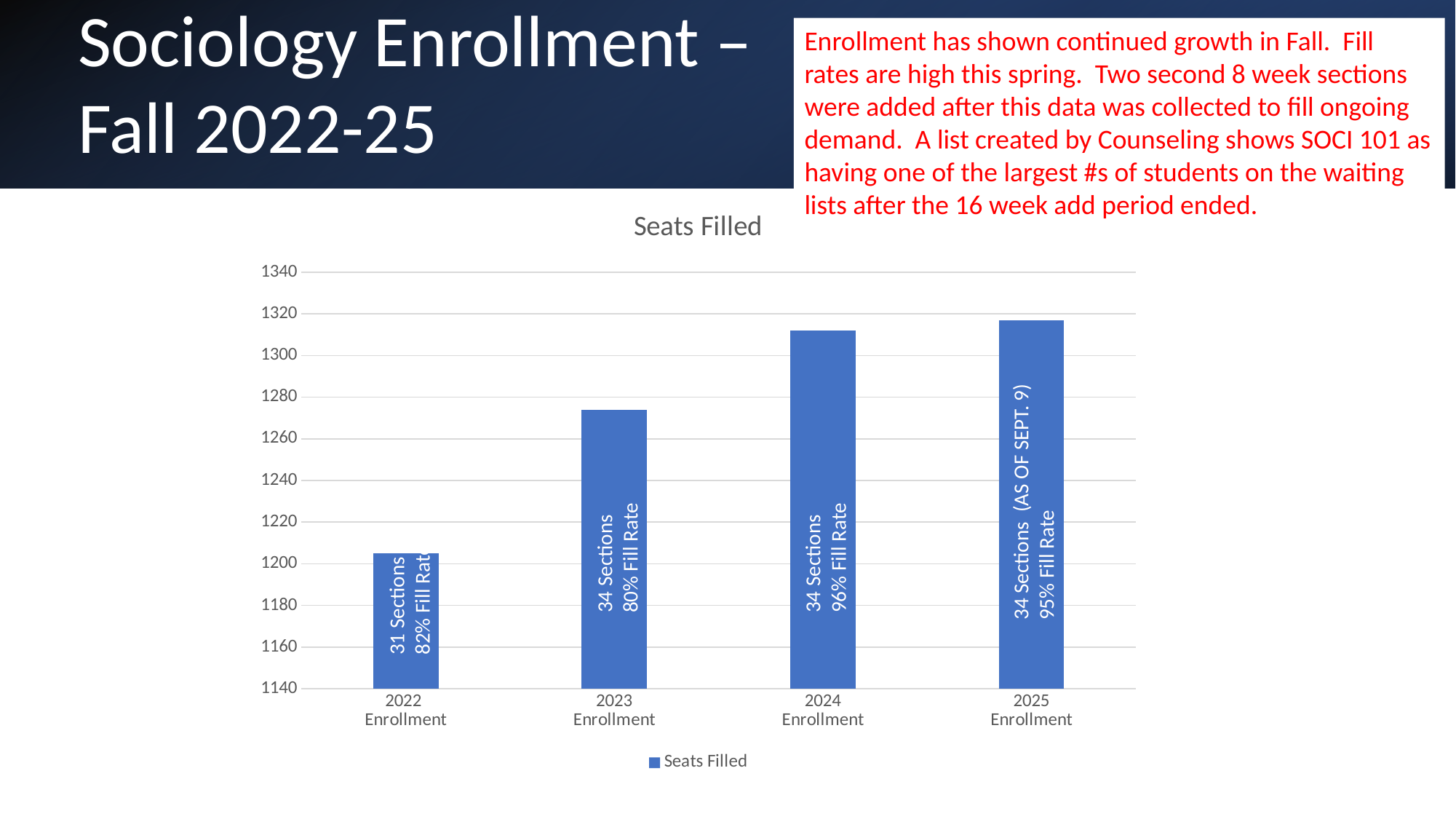
Is the value for 2022 Enrollment greater or less than 1220? less Is the value for 2023 Enrollment greater or less than 1260? greater How many series does the legend list? 1 Which year has the lowest number of seats filled? 2022 Enrollment How many categories (years) are plotted in the chart? 4 Is the value for 2024 Enrollment greater or less than 1300? greater What is the title of the chart? Seats Filled Do the seats filled values rise or fall from 2022 to 2025? rise How many sections are printed on the 2022 Enrollment bar? 31 Sections Which is larger, the seats filled for 2023 Enrollment or for 2022 Enrollment? 2023 Enrollment What kind of chart is shown on the slide? bar chart What fill rate is printed on the 2024 Enrollment bar? 96% Fill Rate